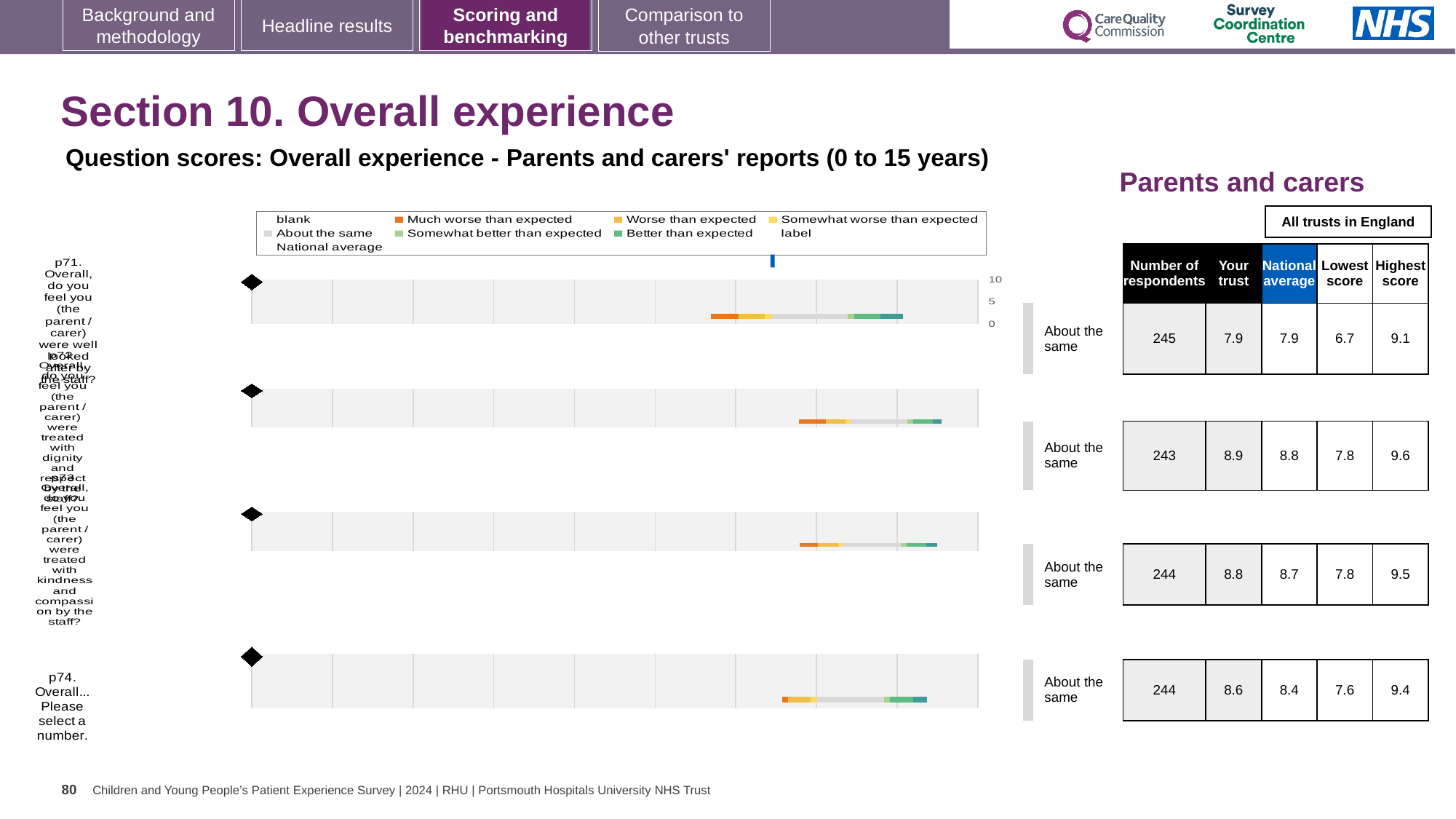
What is the highest score across all trusts in England for the bottom row (p74)? 9.4 Which row has the lowest 'Your trust' score? the top row (p71), 7.9 What is the 'Your trust' score for the bottom row (p74. Overall... Please select a number)? 8.6 What is the number of respondents for the top row (p71)? 245 What kind of chart is used to show the question scores on this slide? bar chart For the second row (p72), which is larger: the 'Your trust' score or the national average? Your trust (8.9) What is the subtitle describing the question scores shown in the chart? Question scores: Overall experience - Parents and carers' reports (0 to 15 years) What benchmark category is shown for every question row on this slide? About the same Which row has the highest 'Your trust' score? the second row (p72), 8.9 What is the national average for the bottom row (p74)? 8.4 How many question rows (bars) are plotted in the chart? 4 For the bottom row (p74), what is the difference between the 'Your trust' score and the national average? 0.2